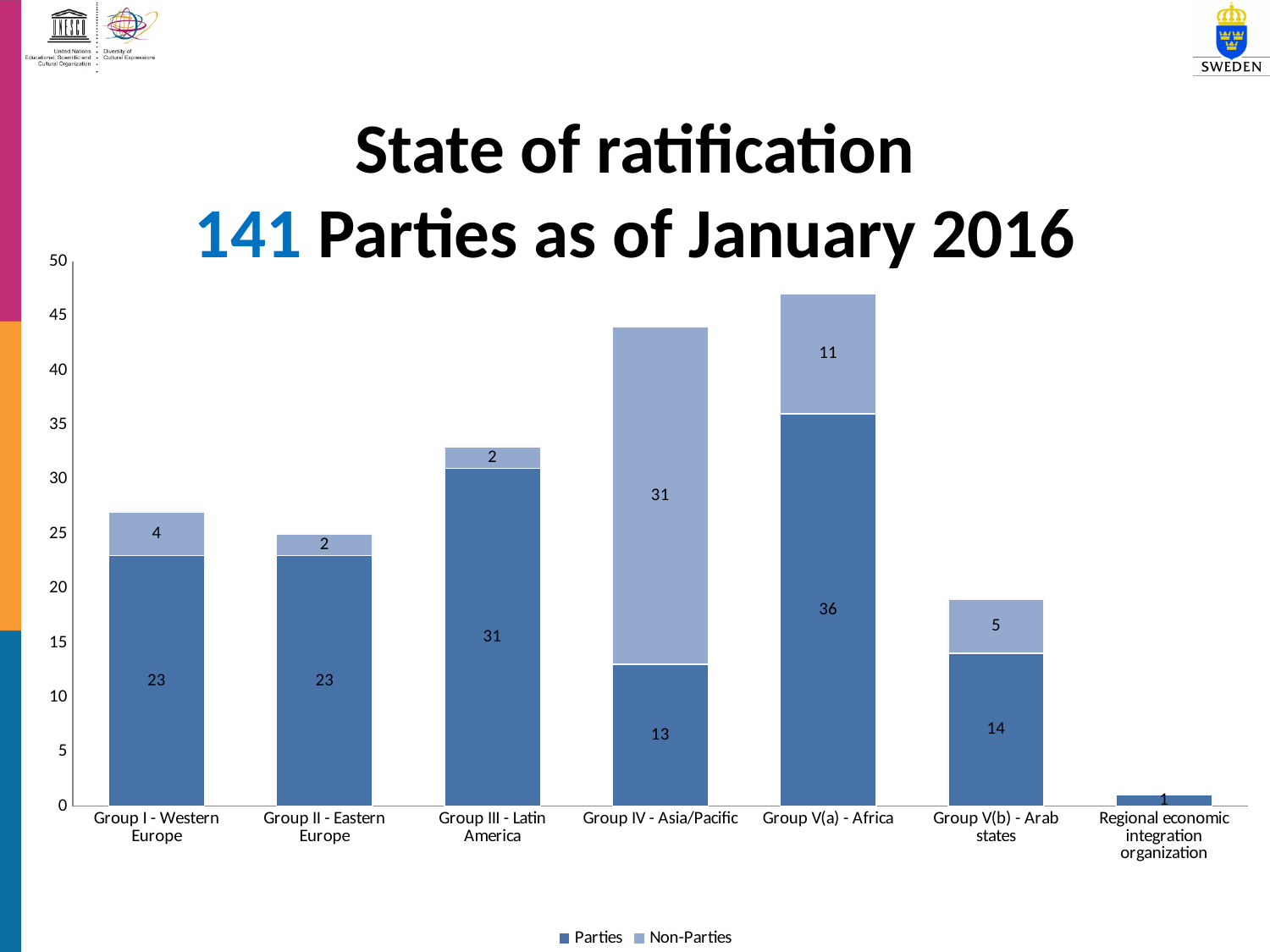
What is the number of Parties for Group V(b) - Arab states? 14 What is the difference between the Parties values for Group III - Latin America and Group IV - Asia/Pacific? 18 How many categories are shown on the x axis? 7 How many series does the legend list? 2 What kind of chart is shown on the slide? Stacked bar chart Which is larger: the Non-Parties value for Group I - Western Europe or for Group V(b) - Arab states? Group V(b) - Arab states What is the total of the stacked bar for Group IV - Asia/Pacific? 44 Which category has the highest number of Parties? Group V(a) - Africa What is the number of Parties for Group V(a) - Africa? 36 Which category has the lowest number of Parties? Regional economic integration organization Is the total height of the stacked bar for Group V(a) - Africa greater or less than 45? greater What is the number of Non-Parties for Group IV - Asia/Pacific? 31